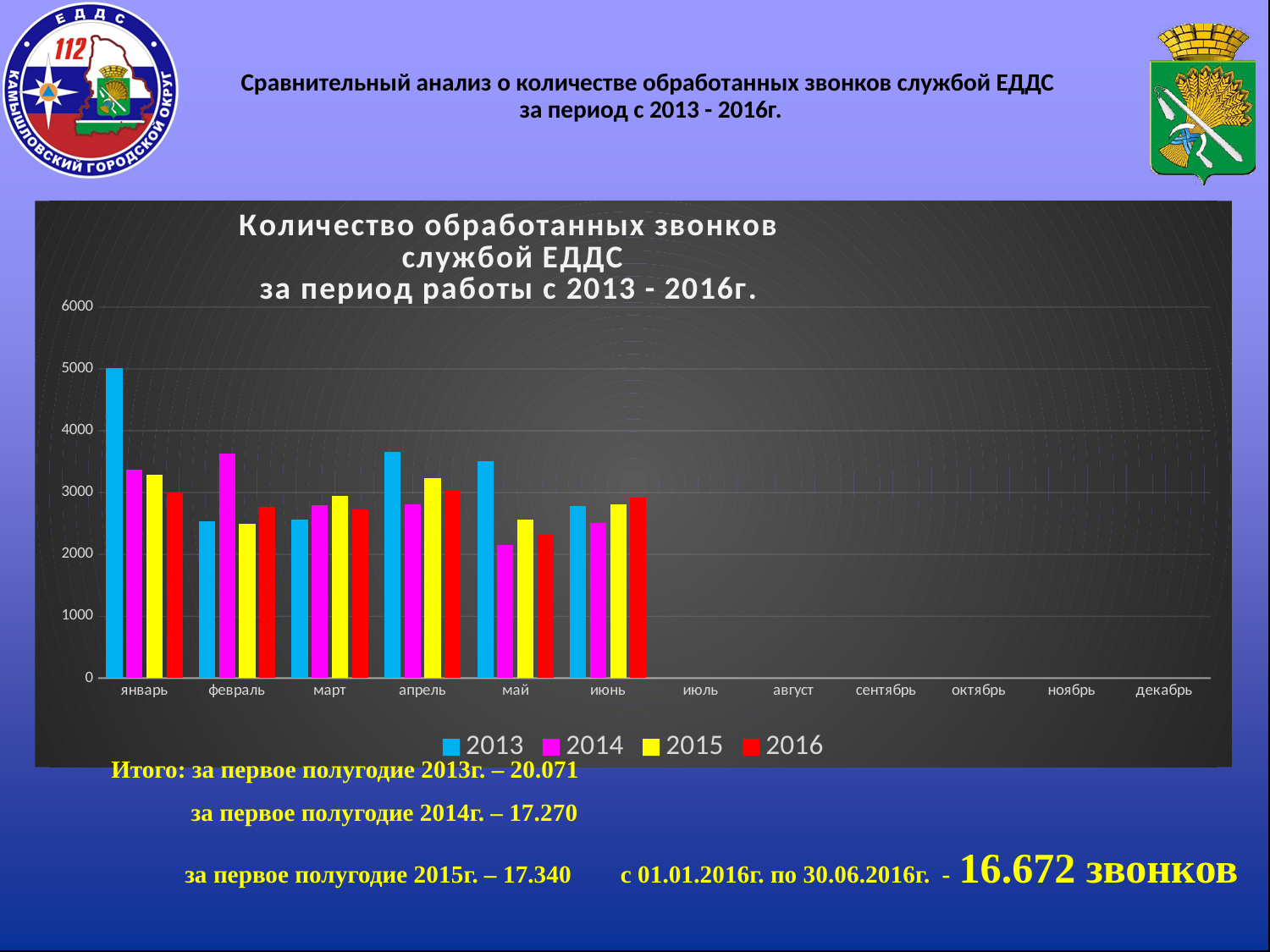
Is the value for 2016 in май greater or less than 3000? less How many series does the legend list? 4 Which month has the highest bar for the 2014 series? февраль For how many months are bars actually plotted? 6 Is the value for 2013 in январь greater or less than 4000? greater Which month has the lowest bar for the 2014 series? май How many month categories are shown on the x axis? 12 What kind of chart is shown on the slide? bar chart In январь, which is larger: the 2013 value or the 2014 value? 2013 Which month has the highest bar for the 2013 series? январь Which colour represents the 2016 series in the legend? red Is the value for 2014 in февраль greater or less than 3000? greater